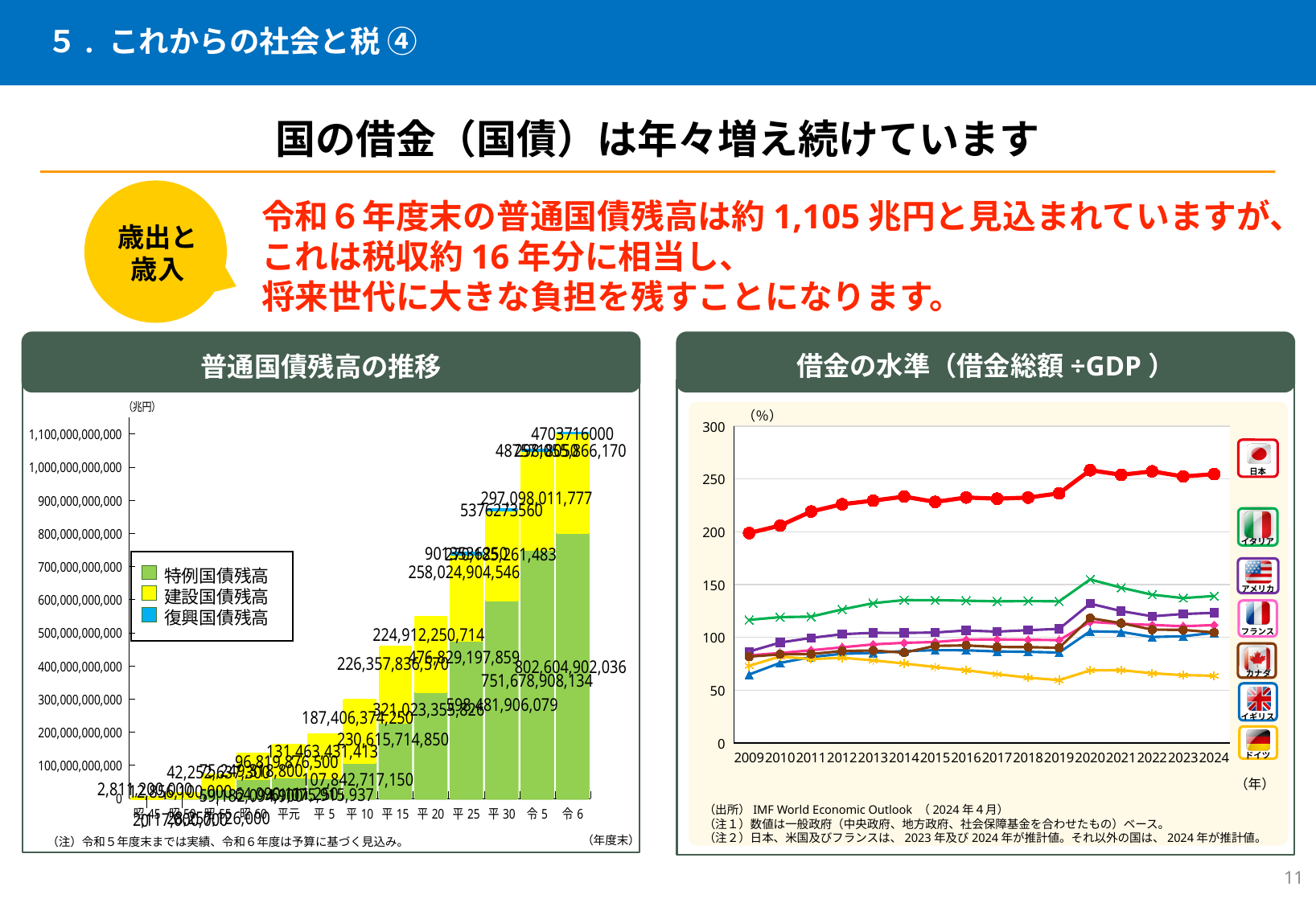
How many countries does the legend of the right chart (借金の水準) list? 7 In the left chart (普通国債残高の推移), do the stacked bars rise or fall from left to right along the x axis? rise What kind of chart is the left chart titled 普通国債残高の推移? bar chart In the right chart (借金の水準), is the value for 日本 in 2024 greater or less than 250? greater How many series does the legend of the left chart (普通国債残高の推移) list? 3 In the left chart (普通国債残高の推移), which year has the tallest stacked bar? 令6 What kind of chart is the right chart titled 借金の水準（借金総額÷GDP）? line chart In the right chart (借金の水準), how many years are shown on the x axis? 16 In the left chart (普通国債残高の推移), which series is shown in yellow? 建設国債残高 In the left chart (普通国債残高の推移), is the total for 令6 greater or less than 1,000,000,000,000? greater In the right chart (借金の水準), which country has the highest line throughout the period? 日本 In the right chart (借金の水準), which country has the lowest value in 2024? ドイツ